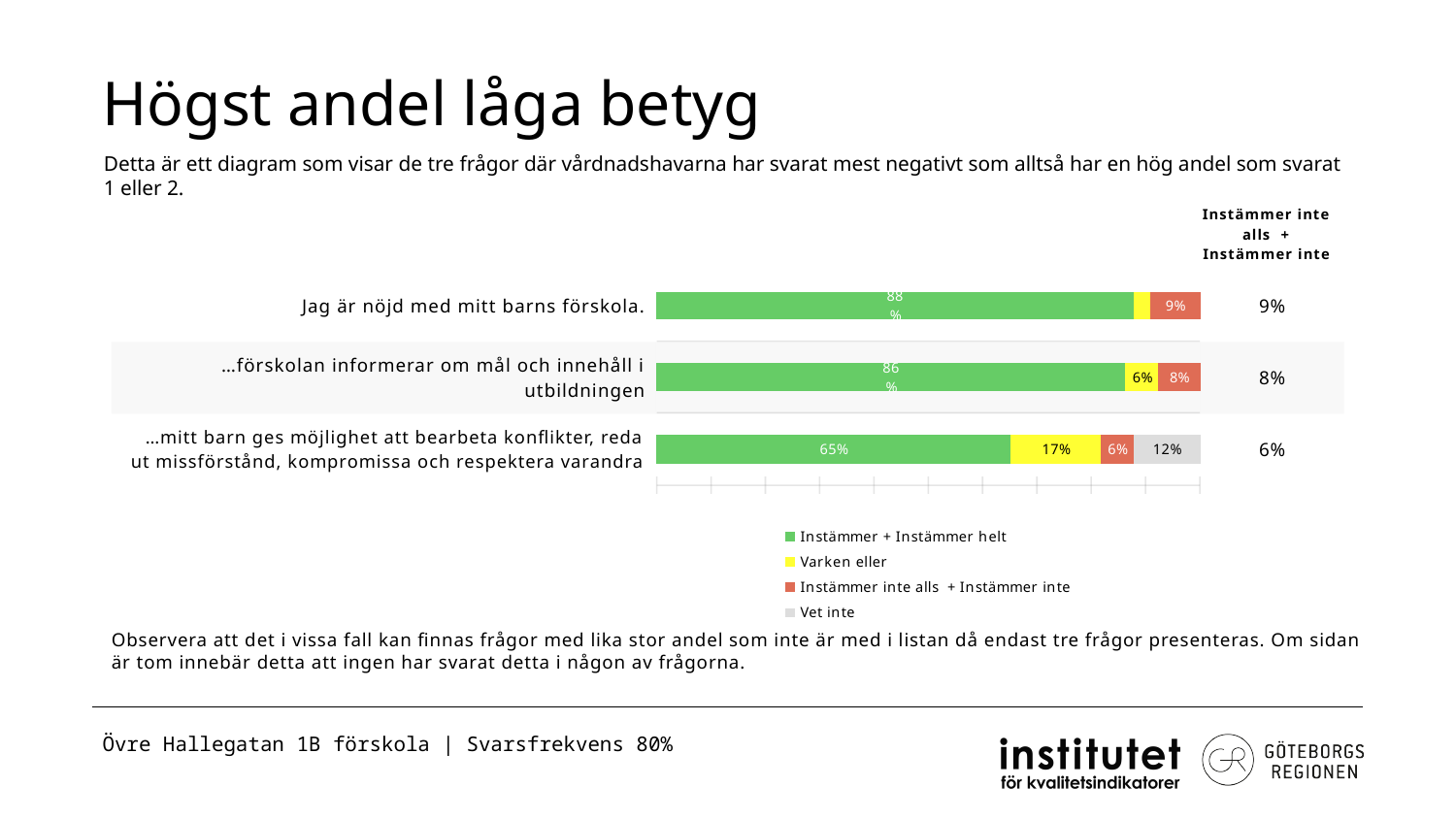
What is the "Vet inte" value for "…mitt barn ges möjlighet att bearbeta konflikter, reda ut missförstånd, kompromissa och respektera varandra"? 12% What is the "Varken eller" value for "…mitt barn ges möjlighet att bearbeta konflikter, reda ut missförstånd, kompromissa och respektera varandra"? 17% Which category has the lowest "Instämmer + Instämmer helt" value? …mitt barn ges möjlighet att bearbeta konflikter, reda ut missförstånd, kompromissa och respektera varandra Which has the larger "Varken eller" value: "…förskolan informerar om mål och innehåll i utbildningen" or "…mitt barn ges möjlighet att bearbeta konflikter, reda ut missförstånd, kompromissa och respektera varandra"? …mitt barn ges möjlighet att bearbeta konflikter, reda ut missförstånd, kompromissa och respektera varandra What is the difference in "Instämmer + Instämmer helt" between "Jag är nöjd med mitt barns förskola." and "…mitt barn ges möjlighet att bearbeta konflikter, reda ut missförstånd, kompromissa och respektera varandra"? 23 percentage points What is the value of "Instämmer + Instämmer helt" for "Jag är nöjd med mitt barns förskola."? 88% What is the "Instämmer inte alls + Instämmer inte" value for "Jag är nöjd med mitt barns förskola."? 9% What kind of chart is shown on the slide? Stacked bar chart How many series does the legend list? 4 What is the value of "Instämmer inte alls + Instämmer inte" for "…förskolan informerar om mål och innehåll i utbildningen"? 8% How many categories (questions) are shown in the chart? 3 Which category has the highest "Instämmer + Instämmer helt" value? Jag är nöjd med mitt barns förskola.